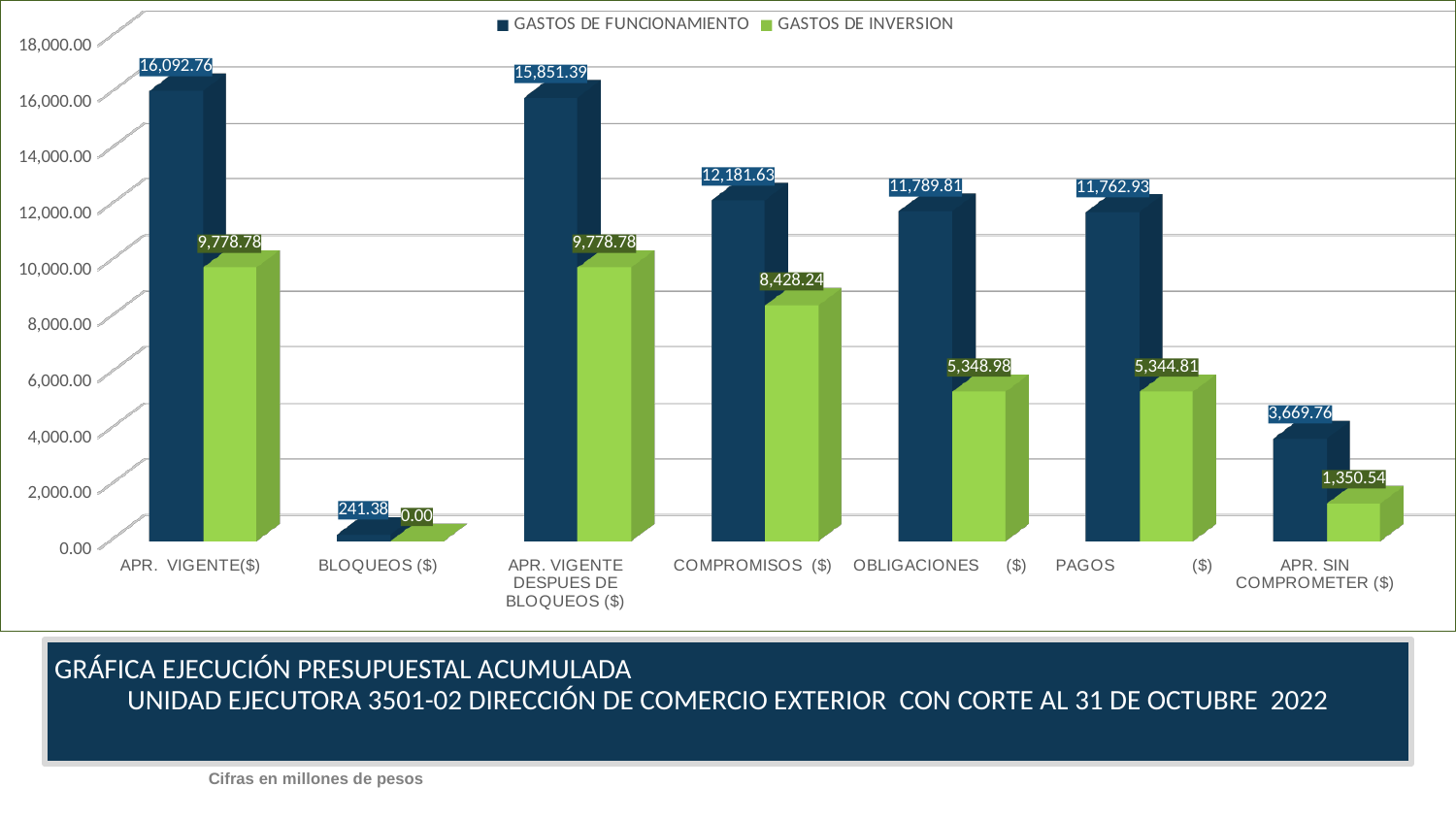
What is the value of GASTOS DE FUNCIONAMIENTO for APR. SIN COMPROMETER ($)? 3,669.76 What is the value of GASTOS DE FUNCIONAMIENTO for APR. VIGENTE($)? 16,092.76 What is the difference between GASTOS DE FUNCIONAMIENTO and GASTOS DE INVERSION for COMPROMISOS ($)? 3,753.39 What is the difference between the GASTOS DE FUNCIONAMIENTO values for APR. VIGENTE($) and APR. VIGENTE DESPUES DE BLOQUEOS ($)? 241.37 How many series does the legend list? 2 What kind of chart is shown on the slide? Bar chart Which category has the highest GASTOS DE FUNCIONAMIENTO value? APR. VIGENTE($) What is the value of GASTOS DE INVERSION for COMPROMISOS ($)? 8,428.24 Which category has the lowest GASTOS DE INVERSION value? BLOQUEOS ($) Which is larger: GASTOS DE INVERSION for OBLIGACIONES ($) or GASTOS DE INVERSION for APR. SIN COMPROMETER ($)? OBLIGACIONES ($) How many categories are shown on the x axis? 7 What is the value of GASTOS DE INVERSION for BLOQUEOS ($)? 0.00